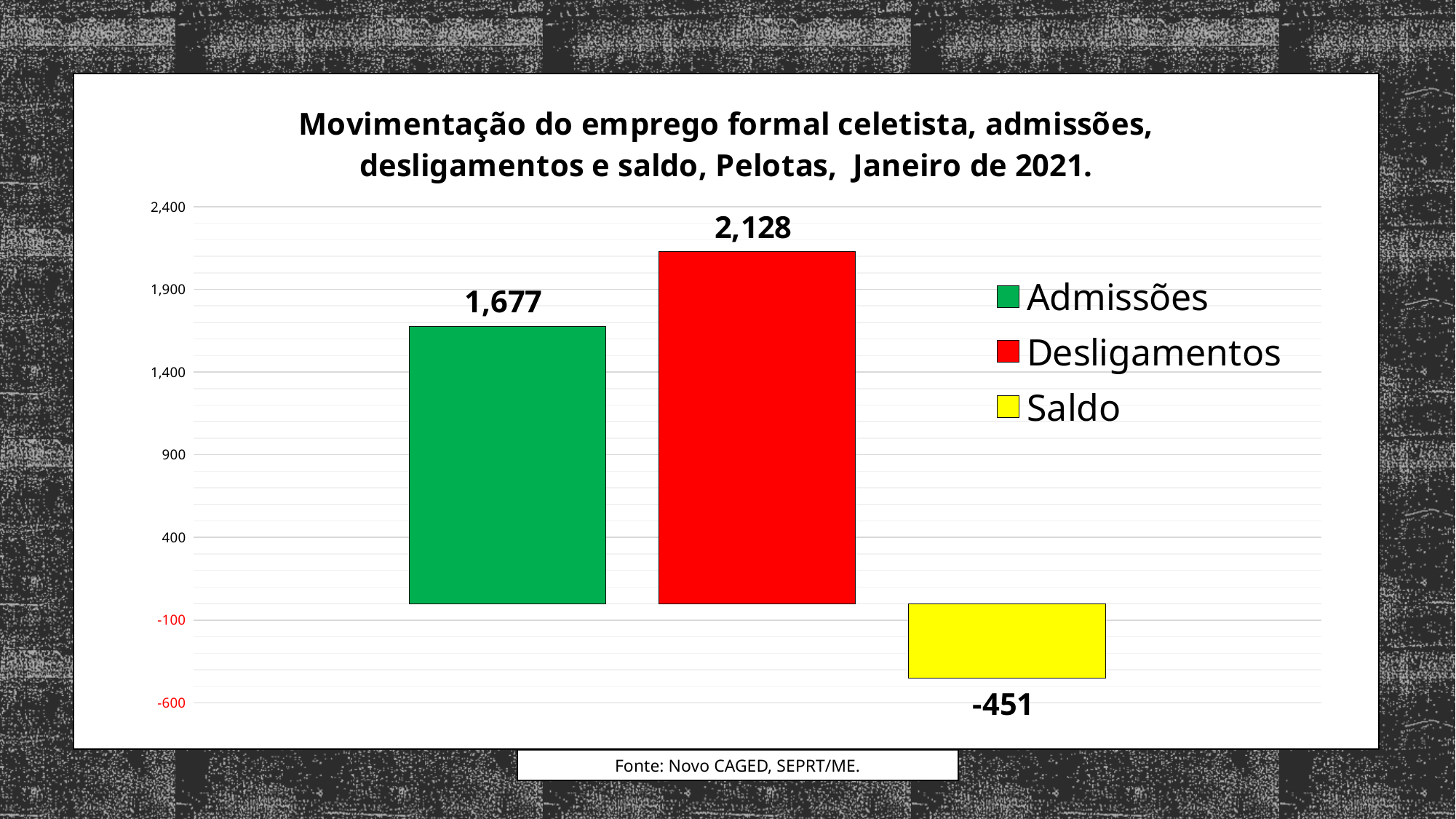
How many bars are plotted in the chart? 3 What colour is the bar for Saldo? yellow What kind of chart is shown on the slide? bar chart Which series has the highest value? Desligamentos How many series does the legend list? 3 Which series has the lowest value? Saldo What is the value for Admissões? 1,677 What is the value for Saldo? -451 What is the difference between Desligamentos and Admissões? 451 Which is larger, Admissões or Desligamentos? Desligamentos Is the value for Admissões greater or less than 1,900? less What is the value for Desligamentos? 2,128